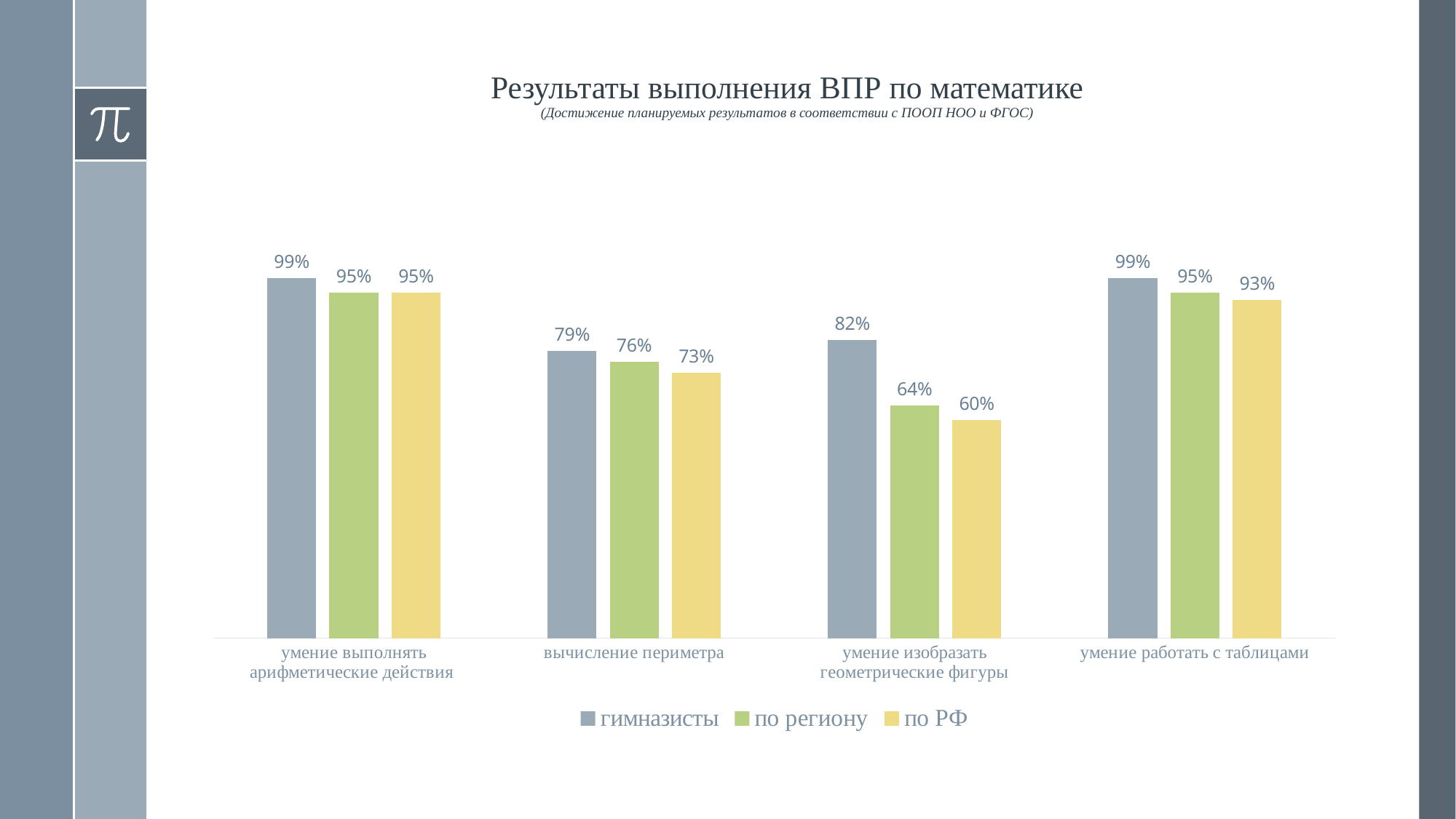
What value is shown for по РФ in the category вычисление периметра? 73% Which is larger in the category умение работать с таблицами: по региону or по РФ? по региону Which category has the lowest value for по РФ? умение изобразать геометрические фигуры How many categories are shown on the x axis? 4 What is the difference between гимназисты and по РФ in the category умение изобразать геометрические фигуры? 22% What is the difference between гимназисты and по региону in the category вычисление периметра? 3% Which category has the highest value for по региону? умение выполнять арифметические действия and умение работать с таблицами (both 95%) What value is shown for по региону in the category умение работать с таблицами? 95% How many series does the legend list? 3 What kind of chart is shown on the slide? bar chart What is the title of the chart? Результаты выполнения ВПР по математике What value is shown for гимназисты in the category умение изобразать геометрические фигуры? 82%